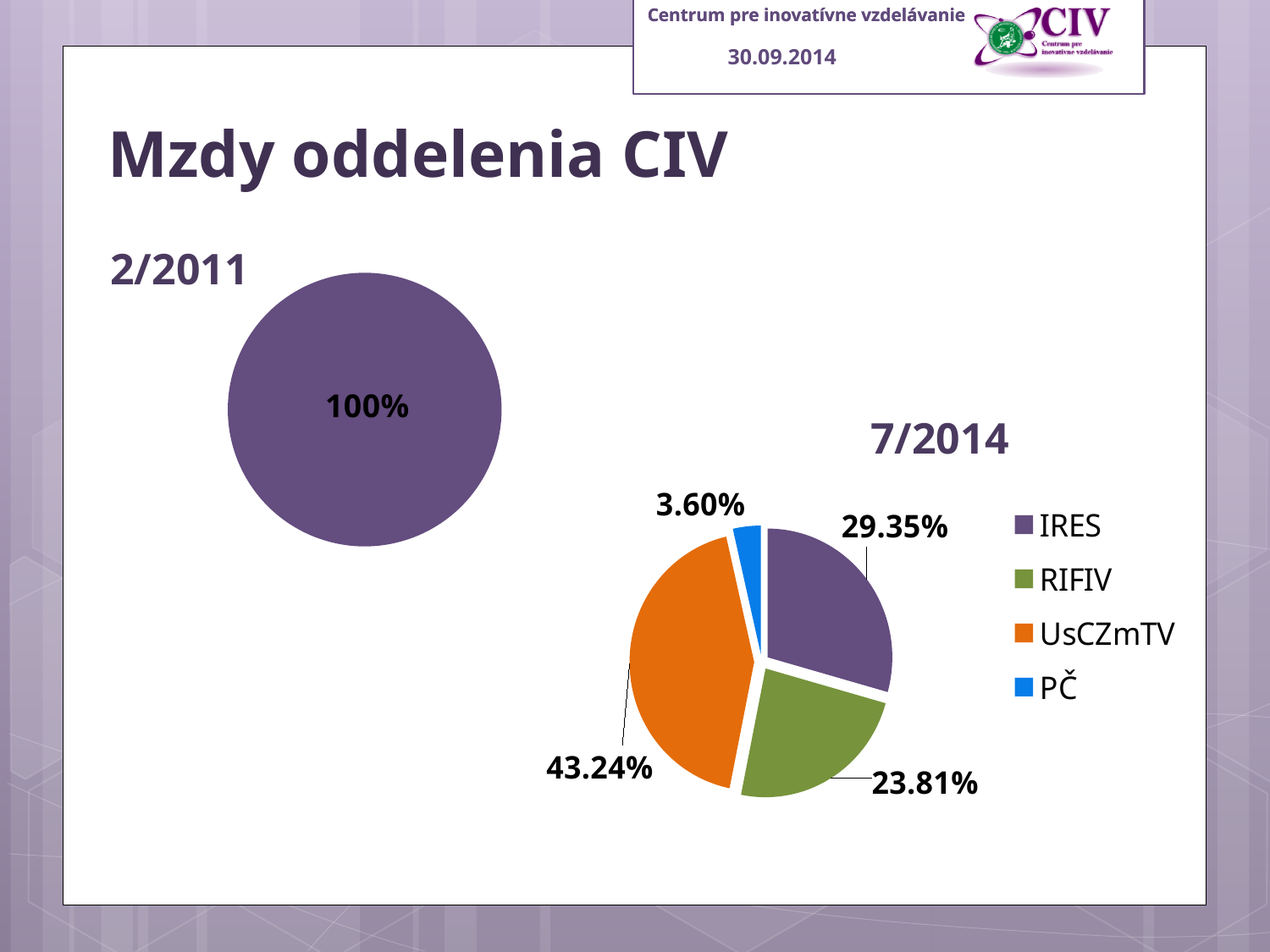
In the 7/2014 chart, which category has the largest share? UsCZmTV In the 7/2014 chart, what share does UsCZmTV have? 43.24% What kind of chart is the 7/2014 chart? pie chart What value is labelled on the 2/2011 chart? 100% In the 7/2014 chart, what share does RIFIV have? 23.81% In the 7/2014 chart, what is the difference between the shares of UsCZmTV and IRES? 13.89% In the 7/2014 chart, which category has the smallest share? PČ In the 7/2014 chart, what share does PČ have? 3.60% In the 7/2014 chart, what colour is the UsCZmTV slice? orange How many categories does the legend of the 7/2014 chart list? 4 In the 7/2014 chart, what share does IRES have? 29.35% In the 7/2014 chart, which is larger, the share of IRES or the share of RIFIV? IRES